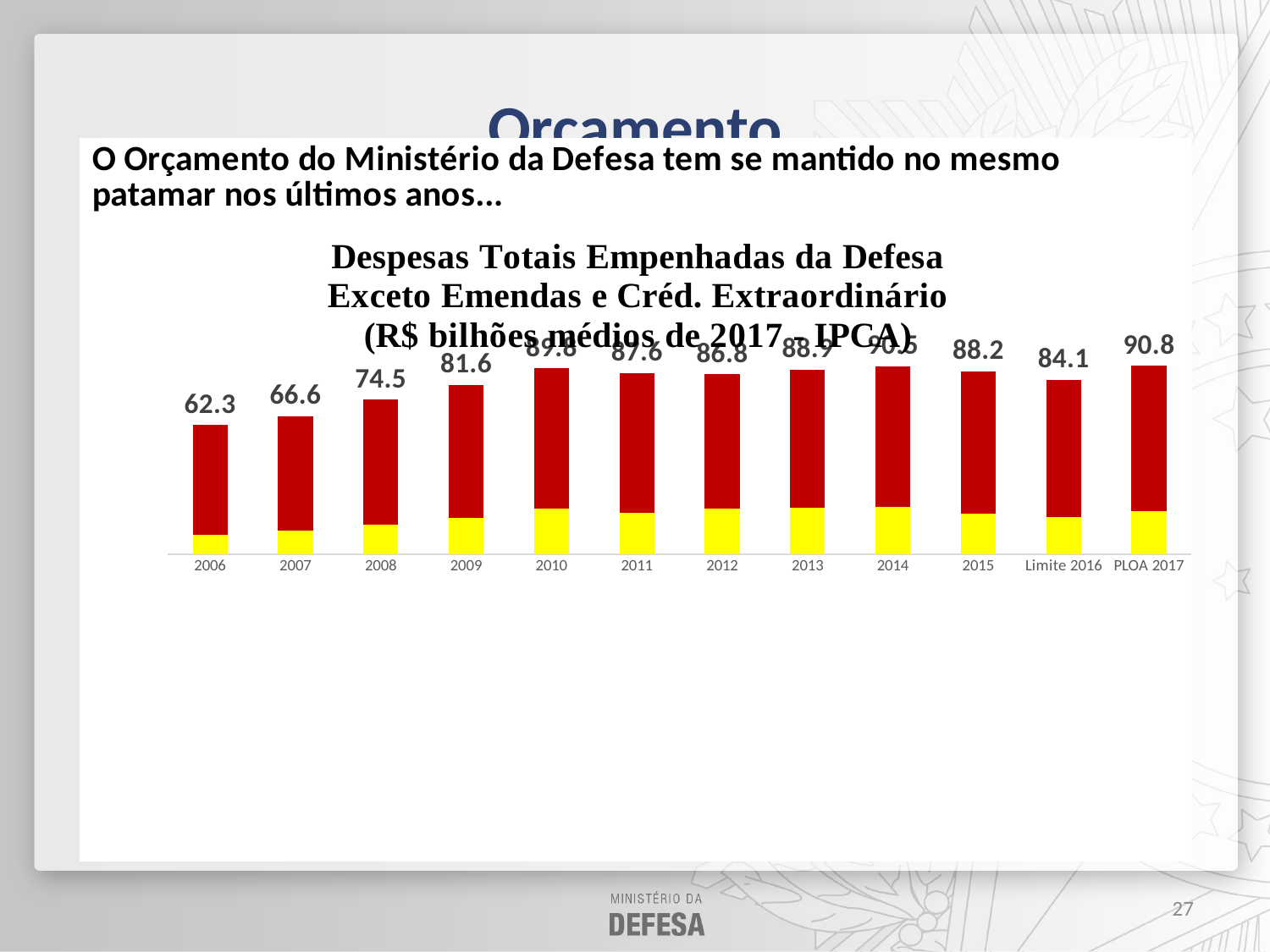
What is the total value shown for Limite 2016? 84.1 What is the total value shown for PLOA 2017? 90.8 What is the total value shown for 2008? 74.5 Do the totals rise or fall from 2006 to 2009? rise What is the difference between the totals for 2007 and 2006? 4.3 Which is larger, the total for 2009 or the total for 2015? 2015 What is the total value shown for 2015? 88.2 What is the total value shown for 2006? 62.3 What is the difference between the totals for PLOA 2017 and Limite 2016? 6.7 How many categories are shown on the x axis? 12 What type of chart is shown on the slide? bar chart Which category has the lowest total value? 2006